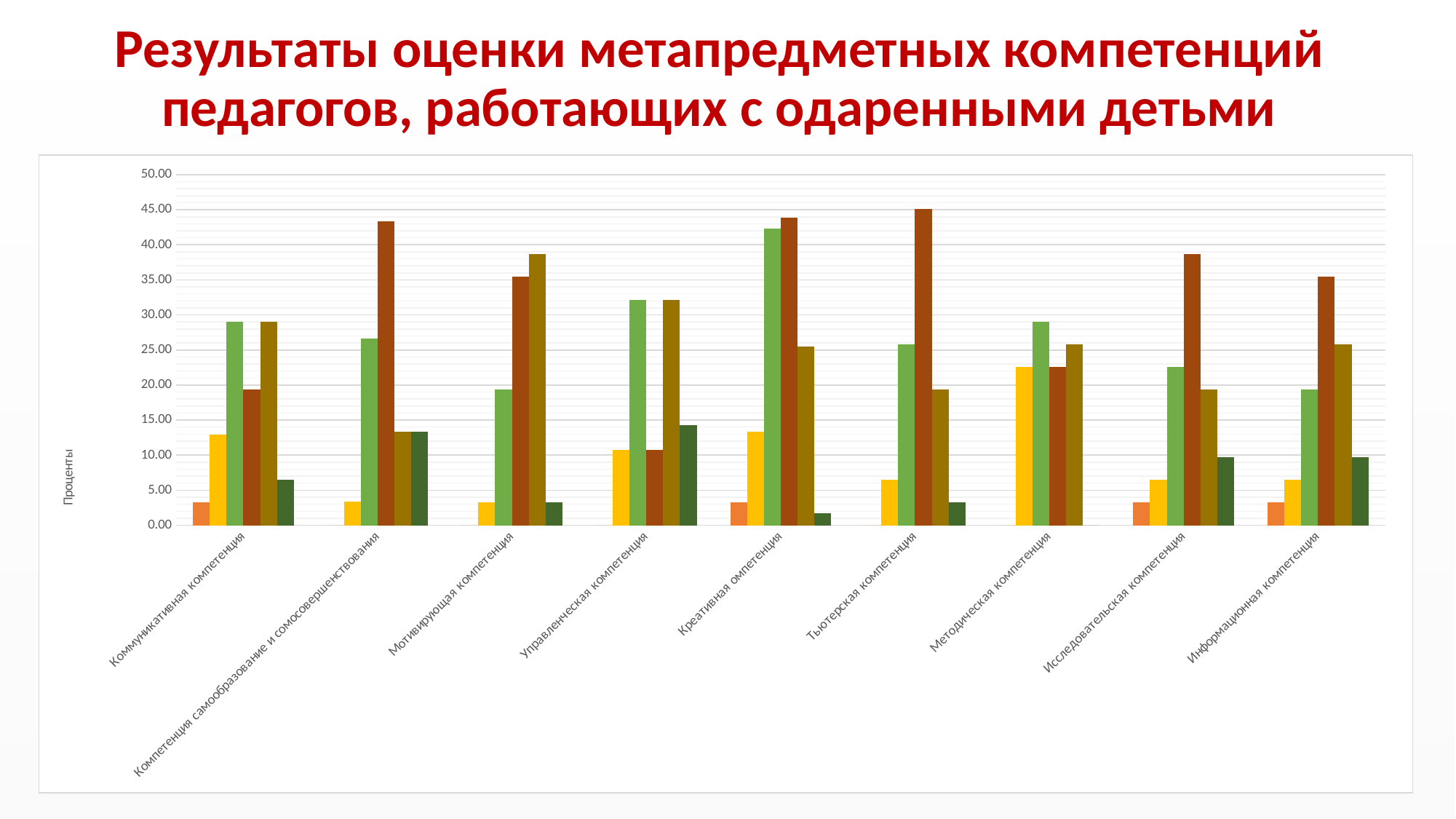
Is the light green bar for Управленческая компетенция greater or less than 30? greater What kind of chart is shown on the slide? bar chart How many competency categories are shown on the x axis of the chart? 9 For Коммуникативная компетенция, which is larger: the light green bar or the brown bar? the light green bar What label is shown on the vertical axis of the chart? Проценты Is the yellow bar for Методическая компетенция greater or less than 20? greater Which is larger: the brown bar for Тьюторская компетенция or the brown bar for Методическая компетенция? Тьютерская компетенция Is the tallest bar for Тьюторская компетенция greater or less than 40? greater Which category contains the tallest bar in the chart? Тьютерская компетенция What is the title of the slide above the chart? Результаты оценки метапредметных компетенций педагогов, работающих с одаренными детьми